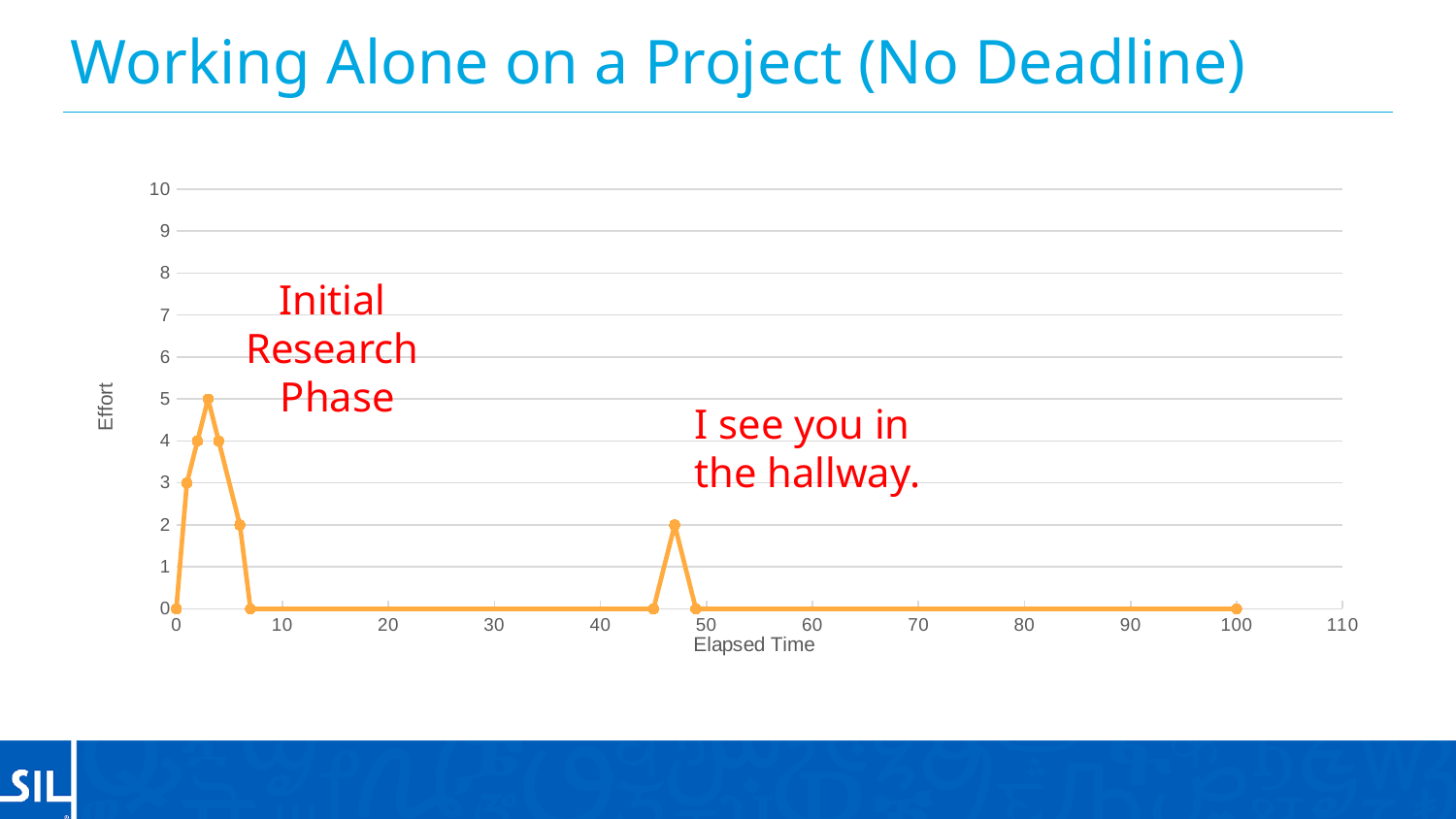
What is the Effort value at Elapsed Time 0? 0 What is the highest Effort value reached on the chart? 5 Does Effort rise or fall between Elapsed Time 3 and Elapsed Time 7? fall Is the peak Effort during the Initial Research Phase greater or less than 4? greater What kind of chart is shown on the slide? line chart What is the title of the slide's chart? Working Alone on a Project (No Deadline) What Effort value does the second, smaller peak (near Elapsed Time 47) reach? 2 What is the Effort value at Elapsed Time 20? 0 What is the difference between the Effort at the first peak and the Effort at the second peak? 3 What is the Effort value at Elapsed Time 100? 0 Which peak is higher: the one in the Initial Research Phase or the one labelled 'I see you in the hallway.'? Initial Research Phase What is the label of the x axis? Elapsed Time